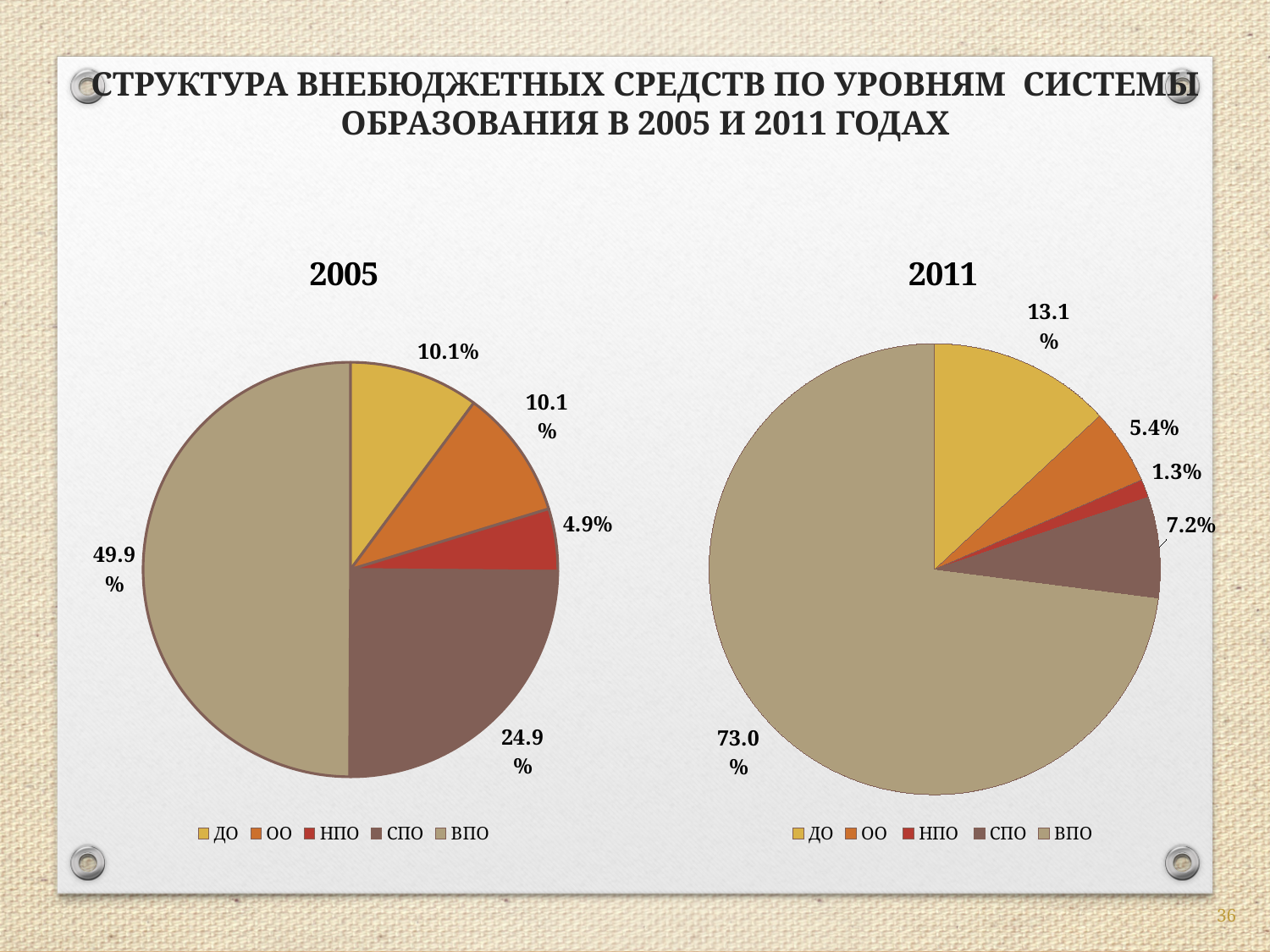
What is the difference between the ВПО share in 2011 and the ВПО share in 2005? 23.1% In the 2011 pie chart, which category has the largest slice? ВПО In the 2011 pie chart, what is the value for НПО? 1.3% In the 2005 pie chart, what is the difference between the СПО and ДО shares? 14.8% In the 2005 pie chart, what is the value for СПО? 24.9% In the 2005 pie chart, which category has the smallest slice? НПО In the 2011 pie chart, which is larger: ДО or СПО? ДО In the 2011 pie chart, which category has the smallest slice? НПО In the 2011 pie chart, what share does ВПО have? 73.0% How many categories does the legend of the 2005 pie chart list? 5 In the 2005 pie chart, what share does ВПО have? 49.9% What type of chart is used for the 2005 data? Pie chart